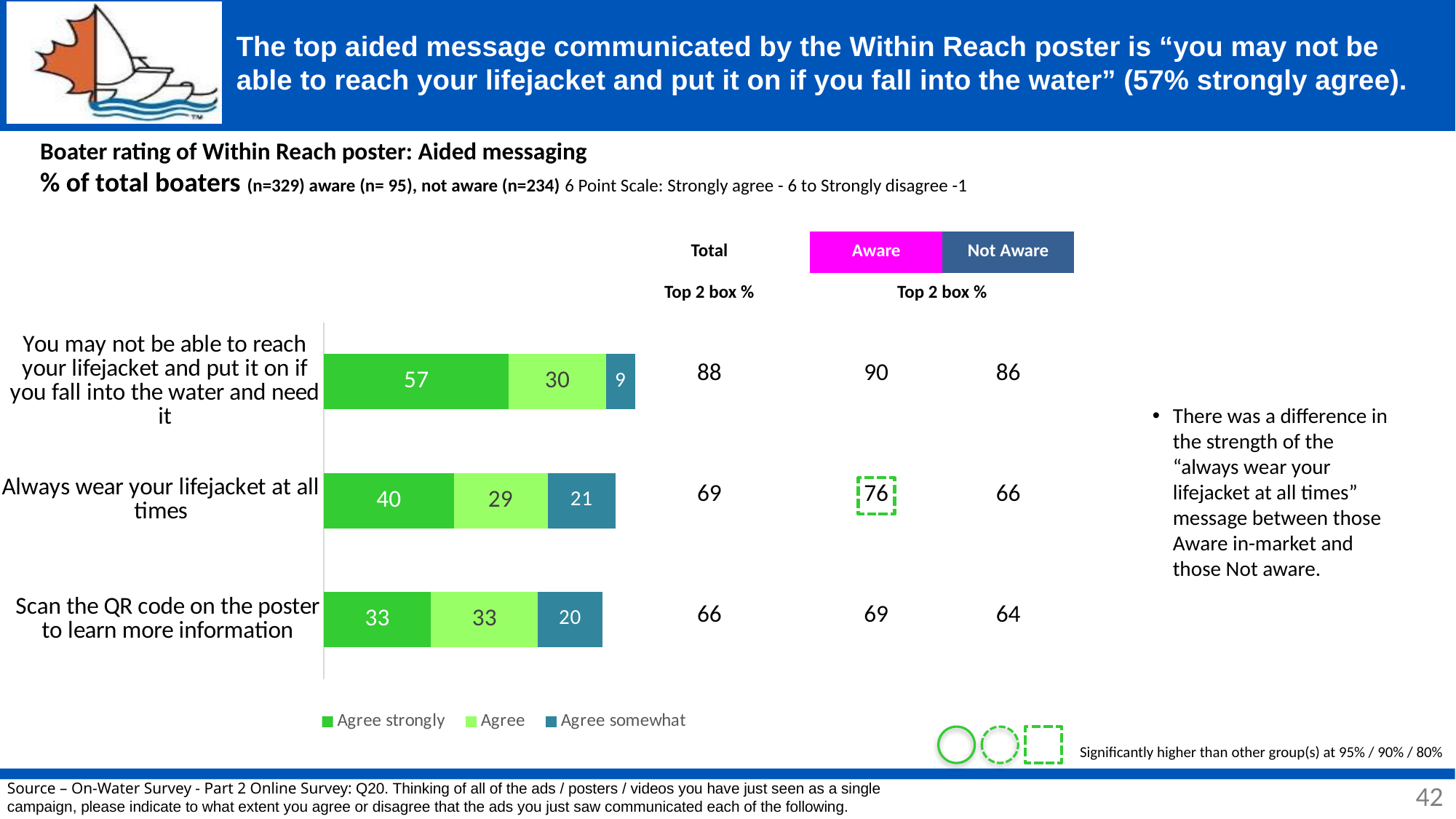
What is the difference between the "Agree strongly" values for "You may not be able to reach your lifejacket..." and "Always wear your lifejacket at all times"? 17 How many messages (categories) are shown in the bar chart? 3 What is the "Agree" value for "Scan the QR code on the poster to learn more information"? 33 What is the total of the stacked bar for "Always wear your lifejacket at all times"? 90 What percentage of boaters agree strongly that the poster communicates "You may not be able to reach your lifejacket and put it on if you fall into the water and need it"? 57 Which message has the highest "Agree strongly" value? You may not be able to reach your lifejacket and put it on if you fall into the water and need it What is the Aware Top 2 box % for "Always wear your lifejacket at all times"? 76 Which message has the lowest "Agree strongly" value? Scan the QR code on the poster to learn more information Is the "Agree somewhat" value larger for "Always wear your lifejacket at all times" or for "You may not be able to reach your lifejacket..."? Always wear your lifejacket at all times How many series does the legend list? 3 What is the "Agree somewhat" value for "Always wear your lifejacket at all times"? 21 What kind of chart is shown on the slide? Stacked bar chart